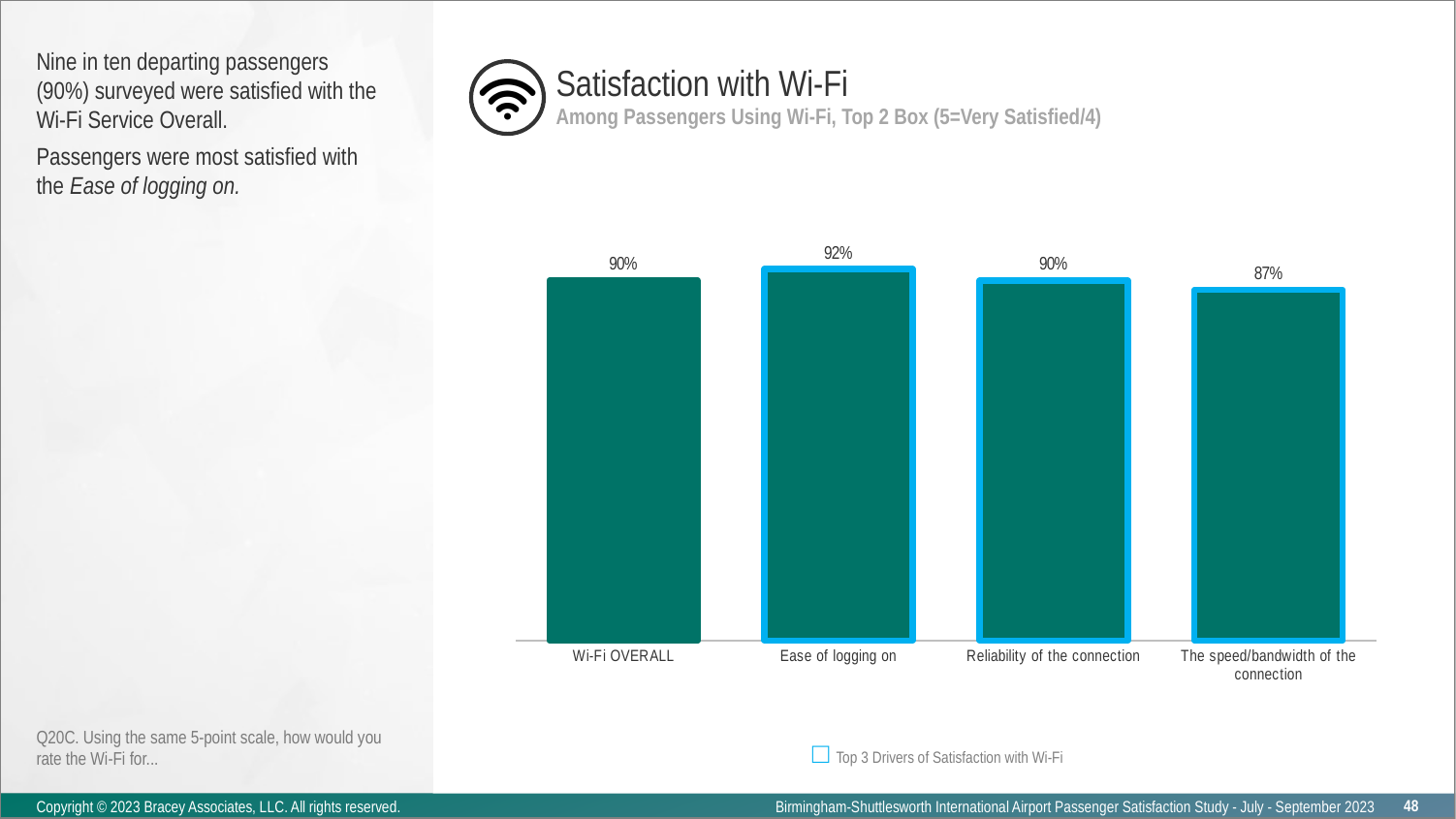
What is the value for Wi-Fi OVERALL? 90% How many categories are shown in the chart? 4 What is the value for Reliability of the connection? 90% Which category has the lowest value? The speed/bandwidth of the connection Which category has the highest value? Ease of logging on What kind of chart is shown on the slide? Bar chart What is the difference between the values for Ease of logging on and The speed/bandwidth of the connection? 5% What is the value for Ease of logging on? 92% Which is larger, the value for Ease of logging on or the value for Reliability of the connection? Ease of logging on What is the value for The speed/bandwidth of the connection? 87% What is the title of the chart? Satisfaction with Wi-Fi What does the blue outline around a bar indicate, according to the legend? Top 3 Drivers of Satisfaction with Wi-Fi